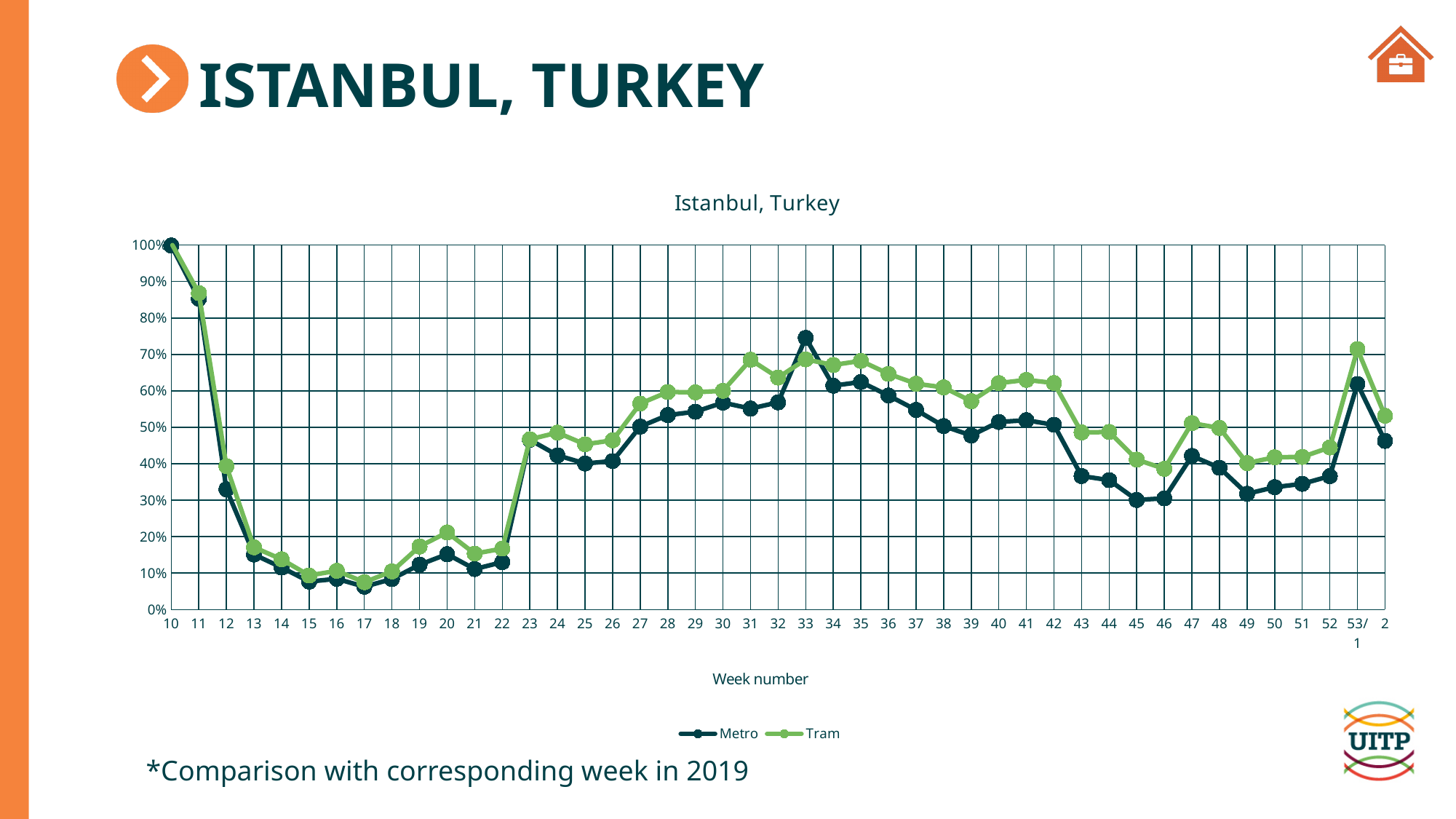
What is the Metro value at week 10? 100% At which week is the Metro series at its highest? 10 At which week is the Metro series at its lowest? 17 How many series does the legend list? 2 At week 43, which series has the higher value, Metro or Tram? Tram Do the Metro values rise or fall from week 10 to week 17? fall At week 33, which series has the higher value, Metro or Tram? Metro Is the Metro value at week 33 greater or less than 70%? greater What are the two series named in the legend? Metro and Tram What kind of chart is shown on the slide? line chart Is the Tram value at week 12 greater or less than 30%? greater Is the Metro value at week 45 greater or less than 40%? less